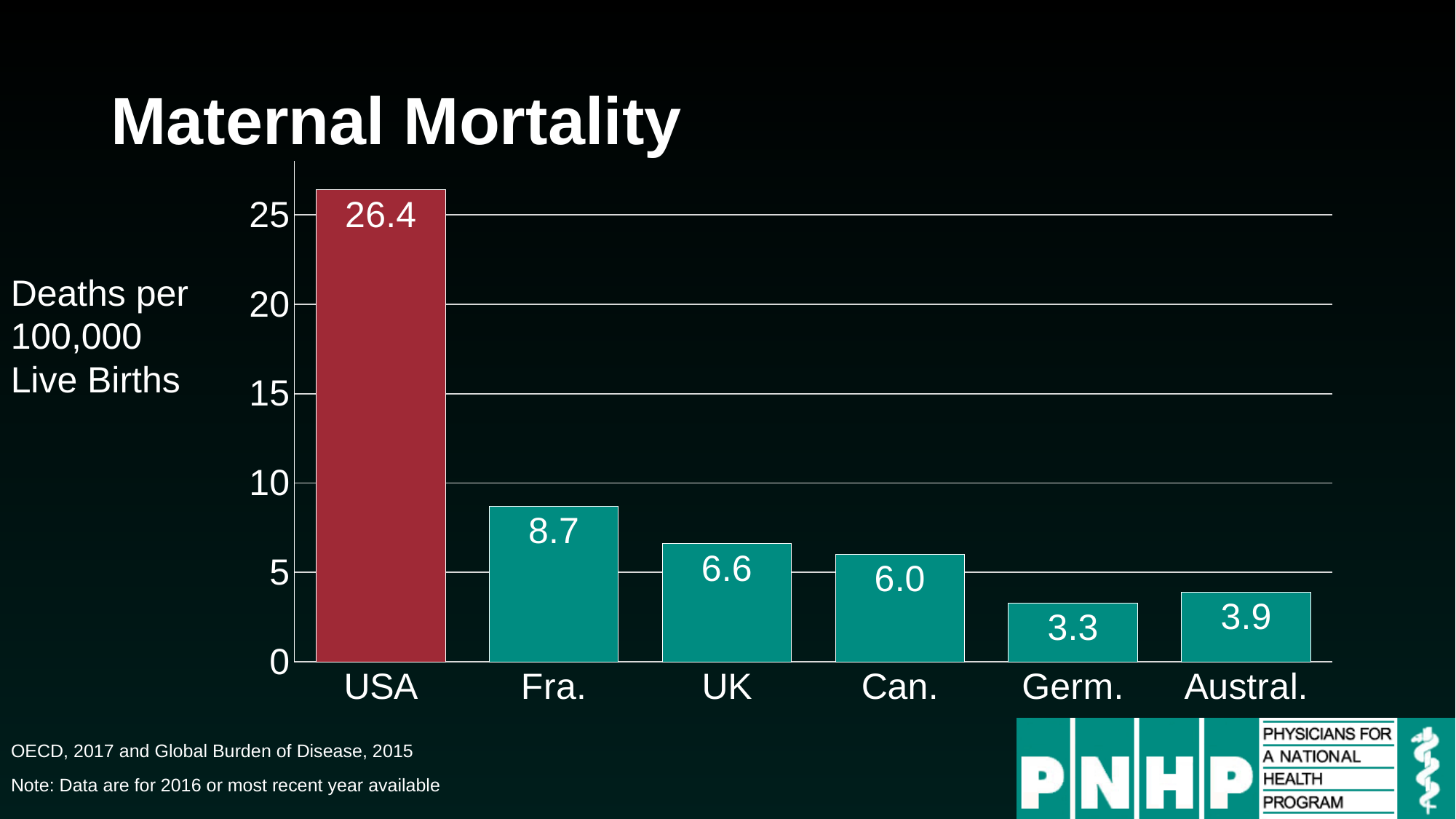
Which country has the highest maternal mortality on the chart? USA What is the title of the chart? Maternal Mortality Which country has the lowest maternal mortality on the chart? Germ. What is the difference between the USA value and the Fra. value? 17.7 What is the maternal mortality value for Can.? 6.0 Which has a higher maternal mortality value, UK or Can.? UK What is the difference between the Austral. value and the Germ. value? 0.6 What is the maternal mortality value for Germ.? 3.3 What is the maternal mortality value for the USA? 26.4 Is the value for Fra. greater or less than 10? less What kind of chart is shown on the slide? bar chart How many countries are shown on the chart? 6